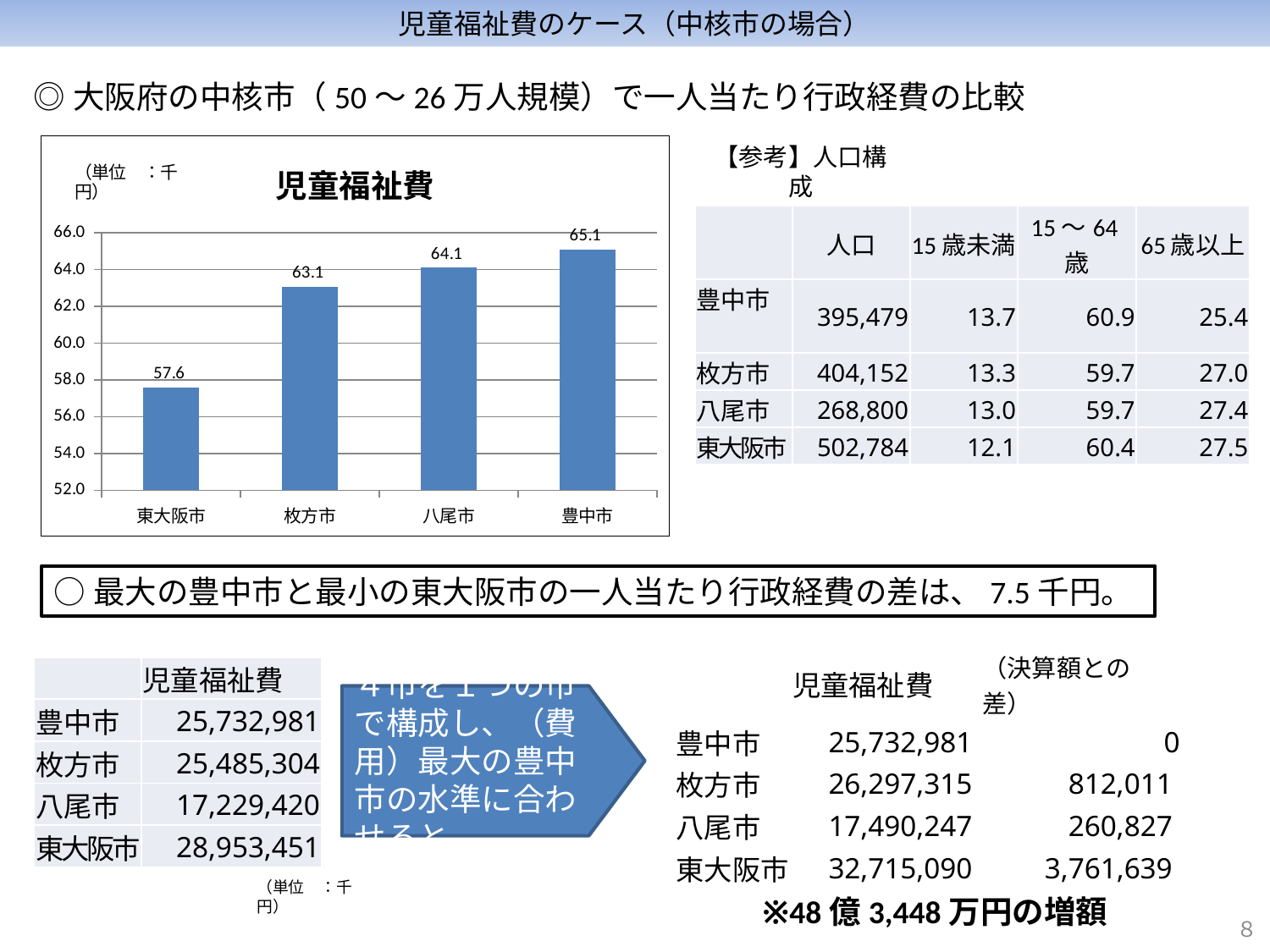
What kind of chart is the 児童福祉費 chart? bar chart In the 児童福祉費 chart, which is larger, the value for 枚方市 or the value for 東大阪市? 枚方市 What is the difference between the values for 豊中市 and 東大阪市 in the 児童福祉費 chart? 7.5 What is the value for 東大阪市 in the 児童福祉費 chart? 57.6 What is the value for 豊中市 in the 児童福祉費 chart? 65.1 How many cities are shown in the 児童福祉費 chart? 4 What is the value for 枚方市 in the 児童福祉費 chart? 63.1 Which city has the highest value in the 児童福祉費 chart? 豊中市 What is the value for 八尾市 in the 児童福祉費 chart? 64.1 Is the value for 東大阪市 in the 児童福祉費 chart greater or less than 60.0? less What unit is indicated for the values in the 児童福祉費 chart? 千円 Which city has the lowest value in the 児童福祉費 chart? 東大阪市